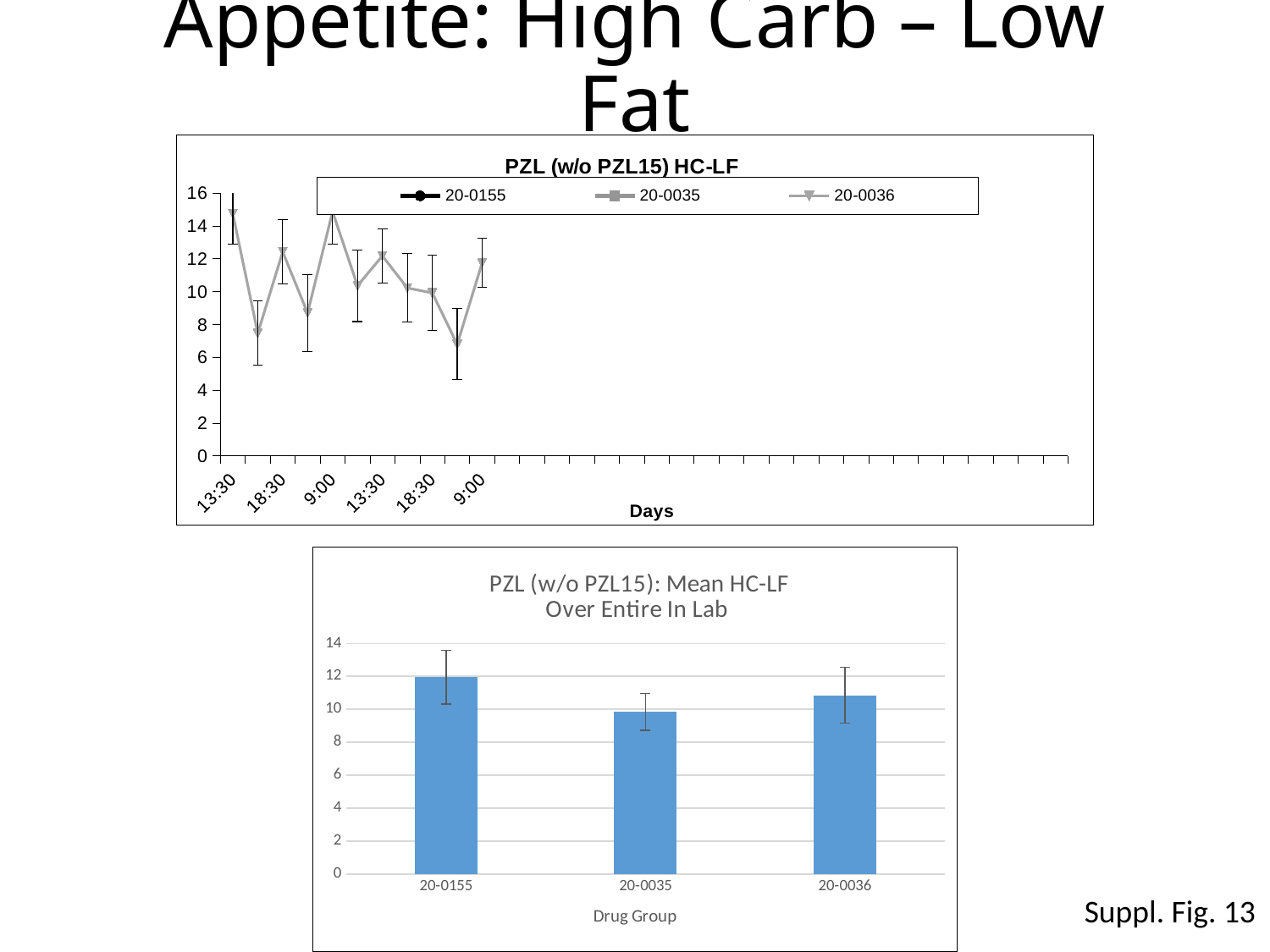
In the top chart "PZL (w/o PZL15) HC-LF", is the value for 20-0036 at the first 13:30 point greater or less than 14? greater In the bottom chart "PZL (w/o PZL15): Mean HC-LF Over Entire In Lab", which drug group has the lowest mean? 20-0035 What is the x-axis title of the top chart "PZL (w/o PZL15) HC-LF"? Days How many series does the legend of the top chart "PZL (w/o PZL15) HC-LF" list? 3 How many drug groups are shown in the bottom chart "PZL (w/o PZL15): Mean HC-LF Over Entire In Lab"? 3 What is the x-axis title of the bottom chart "PZL (w/o PZL15): Mean HC-LF Over Entire In Lab"? Drug Group In the bottom chart "PZL (w/o PZL15): Mean HC-LF Over Entire In Lab", is the value for 20-0155 greater or less than 10? greater In the bottom chart "PZL (w/o PZL15): Mean HC-LF Over Entire In Lab", which is larger, the value for 20-0036 or the value for 20-0035? 20-0036 What kind of chart is the bottom chart titled "PZL (w/o PZL15): Mean HC-LF Over Entire In Lab"? bar chart In the bottom chart "PZL (w/o PZL15): Mean HC-LF Over Entire In Lab", which drug group has the highest mean? 20-0155 What kind of chart is the top chart titled "PZL (w/o PZL15) HC-LF"? line chart